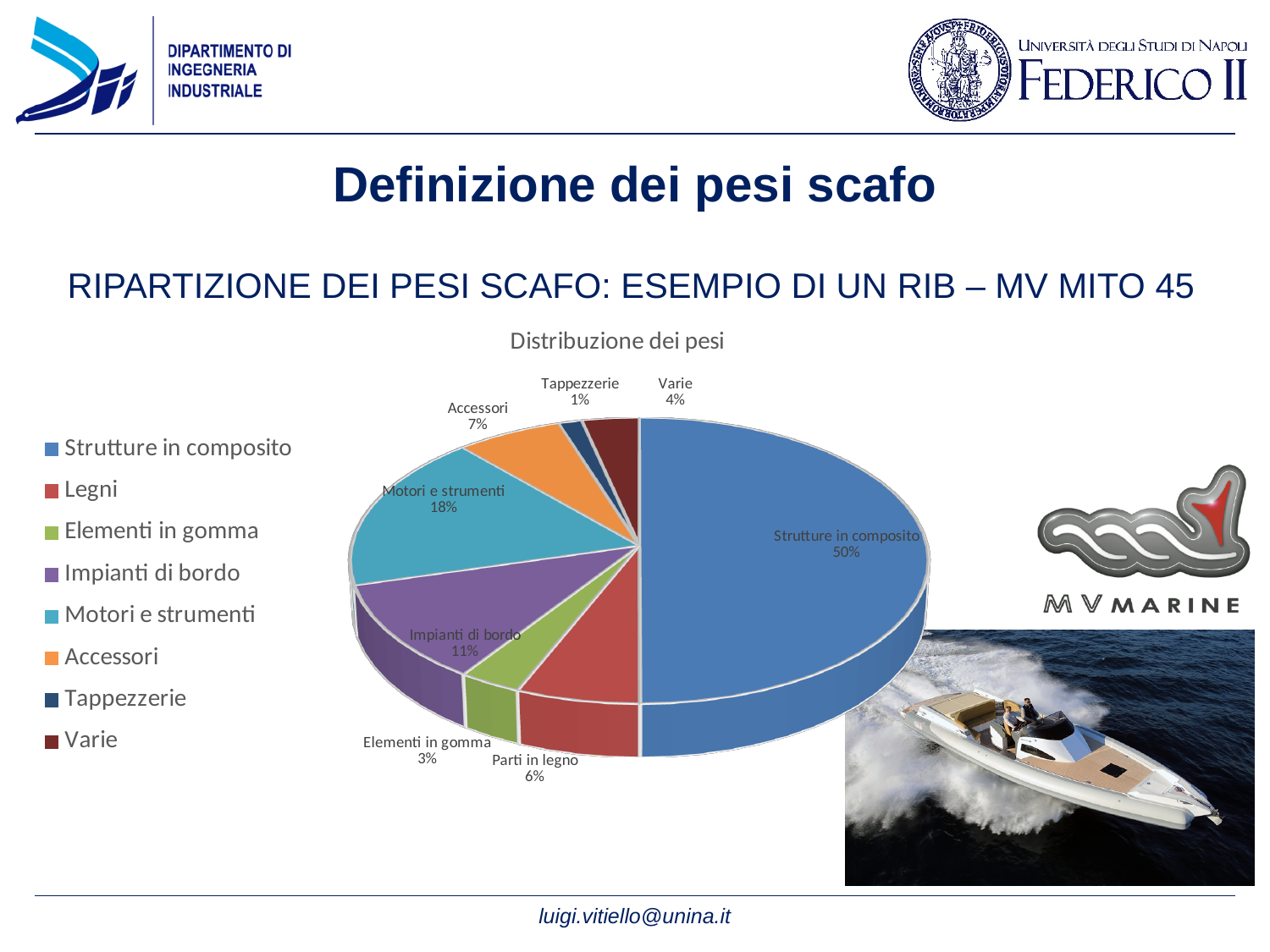
What share of the pie does Strutture in composito have? 50% What is the difference between the shares of Motori e strumenti and Impianti di bordo? 7% Which is larger, the share for Accessori or the share for Parti in legno? Accessori Which category has the largest slice of the pie? Strutture in composito What is the title of the chart? Distribuzione dei pesi What is the combined share of Elementi in gomma and Varie? 7% How many categories does the legend list? 8 Which category has the smallest slice of the pie? Tappezzerie What kind of chart is shown on the slide? pie chart What is the value shown for Impianti di bordo? 11% What is the value shown for Motori e strumenti? 18% What is the value shown for Accessori? 7%